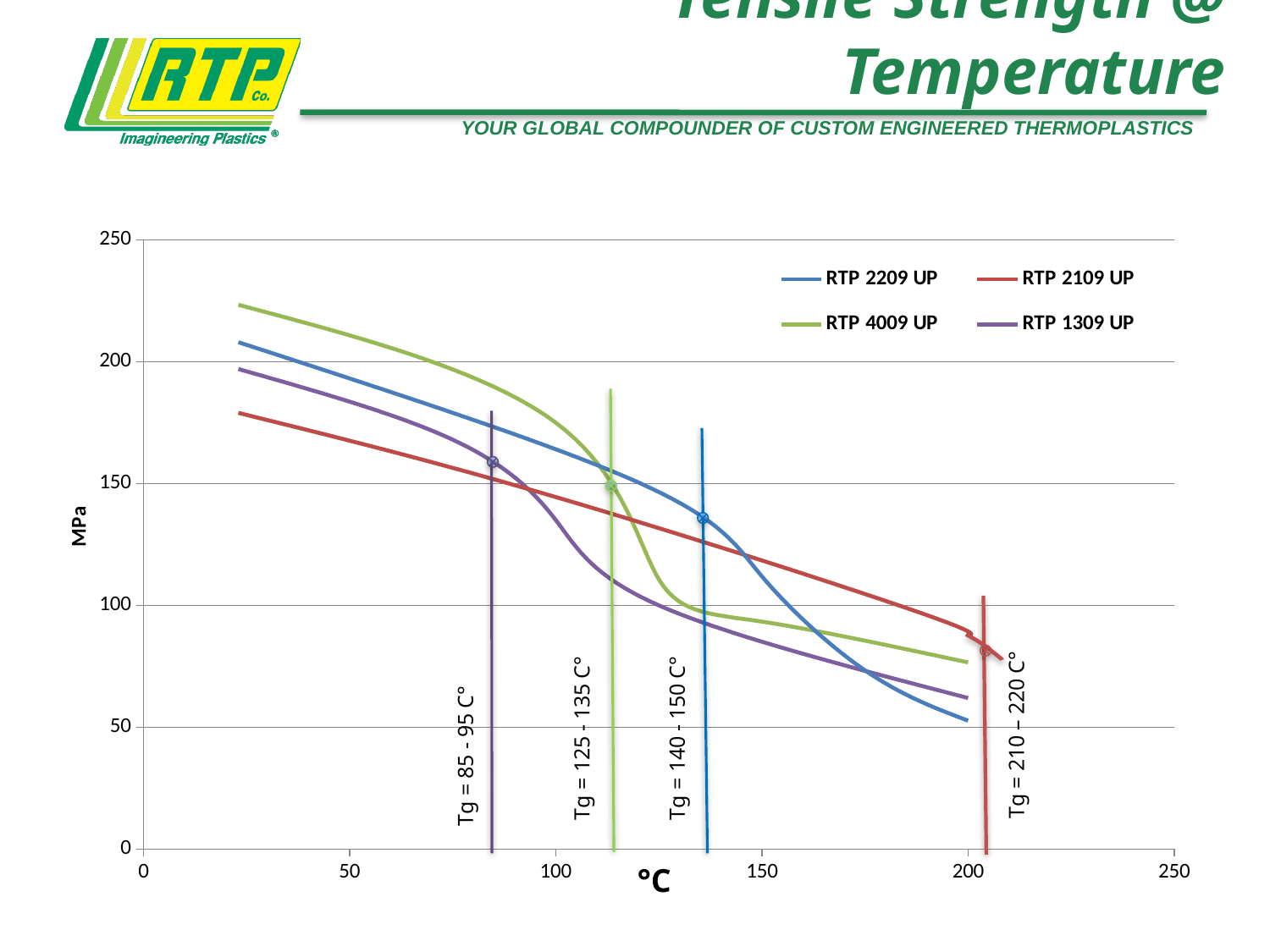
Do the tensile strength values rise or fall as temperature increases along the x axis? fall What kind of chart is shown on the slide? line chart Is the value for RTP 2209 UP at 200 °C greater or less than 100 MPa? less What is the label on the y axis of the chart? MPa Is the value for RTP 2109 UP at 25 °C greater or less than 200 MPa? less Which series has the lowest tensile strength at the lowest temperatures plotted (around 25 °C)? RTP 2109 UP How many series does the legend list? 4 At 200 °C, which series has the higher tensile strength, RTP 2109 UP or RTP 2209 UP? RTP 2109 UP Is the value for RTP 4009 UP at 100 °C greater or less than 150 MPa? greater What Tg range is annotated for the vertical line at about 85 °C? Tg = 85 - 95 C° Which series has the lowest tensile strength at 200 °C? RTP 2209 UP Which series has the highest tensile strength at the lowest temperatures plotted (around 25 °C)? RTP 4009 UP